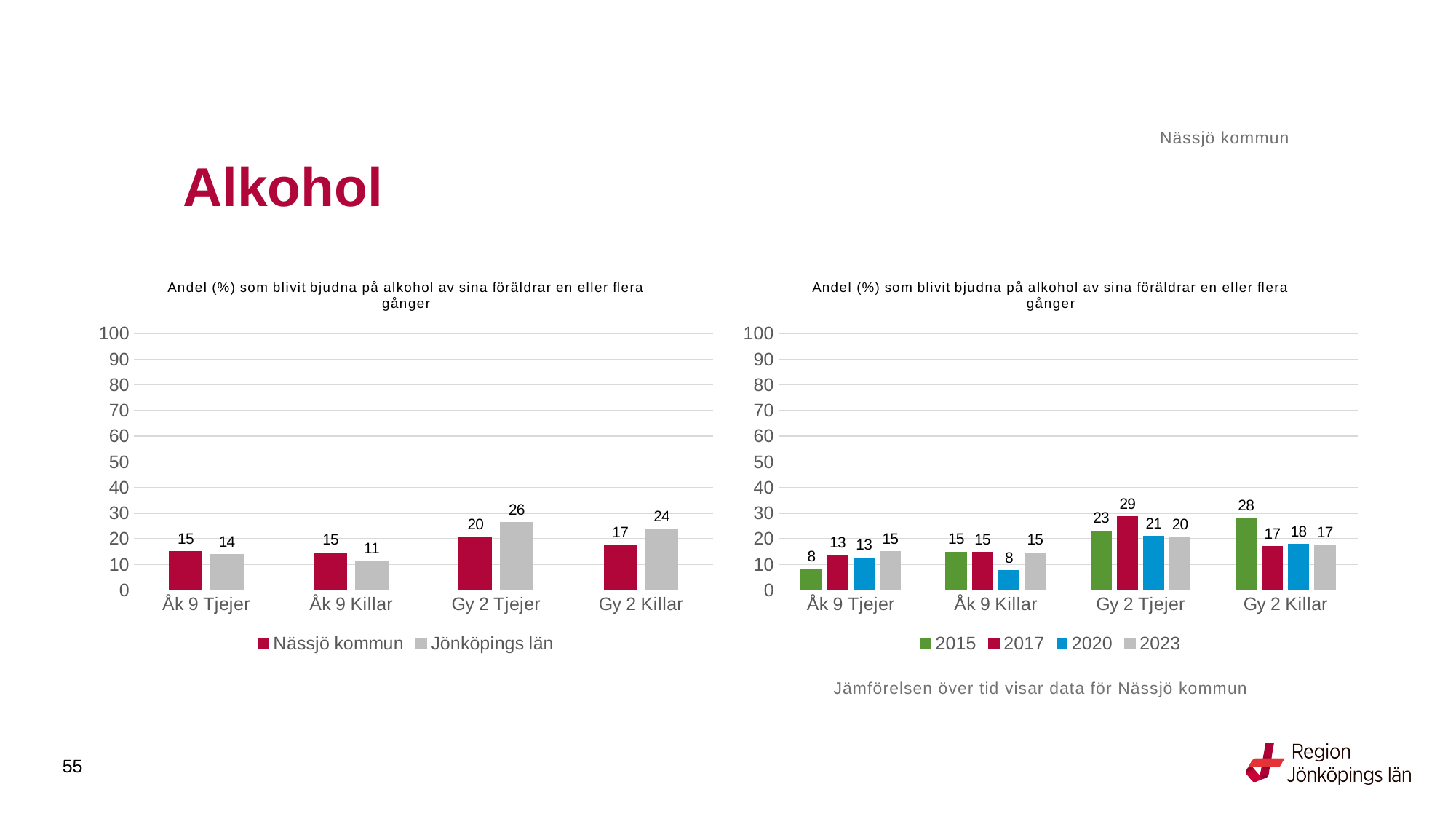
What type of chart is the right chart? Bar chart In the left chart, which is larger for Åk 9 Killar: Nässjö kommun or Jönköpings län? Nässjö kommun In the left chart, which category has the highest value for Jönköpings län? Gy 2 Tjejer In the left chart, what is the value for Nässjö kommun for Gy 2 Tjejer? 20 In the right chart, which year has the highest value for Gy 2 Killar? 2015 In the right chart, what is the value for 2017 for Gy 2 Tjejer? 29 In the left chart, what is the value for Jönköpings län for Gy 2 Killar? 24 In the right chart, what is the difference between 2015 and 2023 for Åk 9 Tjejer? 7 How many series does the legend of the right chart list? 4 In the left chart, what is the difference between Jönköpings län and Nässjö kommun for Gy 2 Killar? 7 In the right chart, what is the value for 2020 for Åk 9 Killar? 8 In the left chart, which category has the lowest value for Jönköpings län? Åk 9 Killar